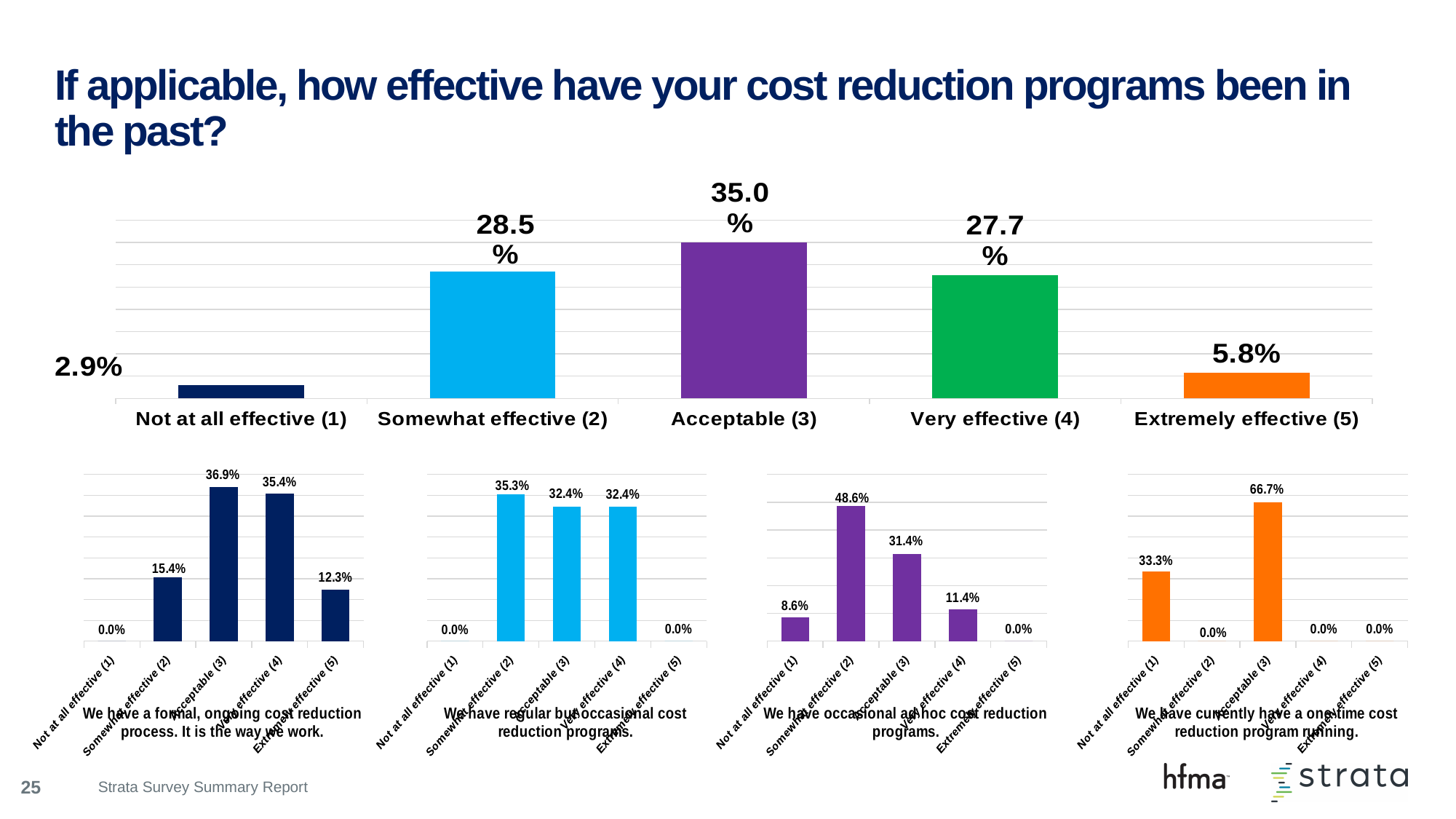
In the large chart at the top of the slide, what is the difference between Somewhat effective (2) and Extremely effective (5)? 22.7% In the small chart titled 'We have a formal, ongoing cost reduction process. It is the way we work.', what is the value for Acceptable (3)? 36.9% In the small chart titled 'We have occasional ad hoc cost reduction programs.', which category has the highest value? Somewhat effective (2) In the small chart titled 'We have currently have a one-time cost reduction program running.', what is the value for Acceptable (3)? 66.7% In the large chart at the top of the slide, how many categories are shown? 5 In the small chart titled 'We have regular but occasional cost reduction programs.', is the value for Somewhat effective (2) larger or smaller than the value for Acceptable (3)? Larger In the large chart at the top of the slide, which category has the highest value? Acceptable (3) In the small chart titled 'We have currently have a one-time cost reduction program running.', what is the difference between Acceptable (3) and Not at all effective (1)? 33.4% In the large chart at the top of the slide, which category has the lowest value? Not at all effective (1) In the large chart at the top of the slide, what is the value for Acceptable (3)? 35.0% What type of chart is the large chart at the top of the slide? Bar chart In the small chart titled 'We have occasional ad hoc cost reduction programs.', what is the value for Not at all effective (1)? 8.6%